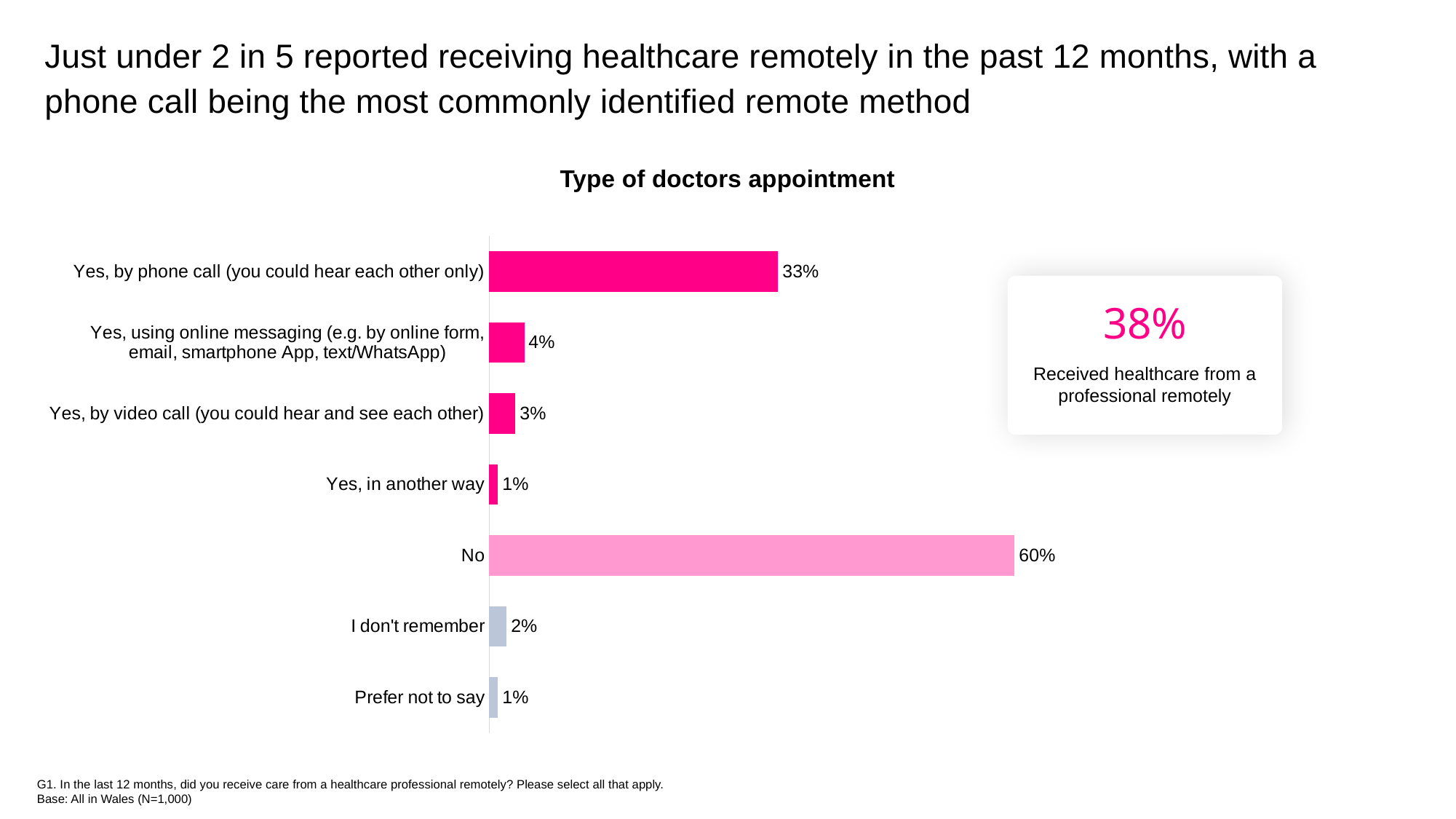
Which is larger: the value for online messaging or the value for video call? Online messaging What is the difference between the 'No' value and the 'Yes, by phone call' value? 27% What is the value for 'Yes, by video call'? 3% What kind of chart is shown on the slide? Bar chart Which category has the highest value in the chart? No What is the value for 'No' in the Type of doctors appointment chart? 60% How many categories are shown in the chart? 7 What percentage reported receiving healthcare by phone call? 33% What is the title of the chart? Type of doctors appointment What percentage said 'I don't remember'? 2% What percentage is shown in the callout box as having received healthcare from a professional remotely? 38% What percentage reported using online messaging? 4%